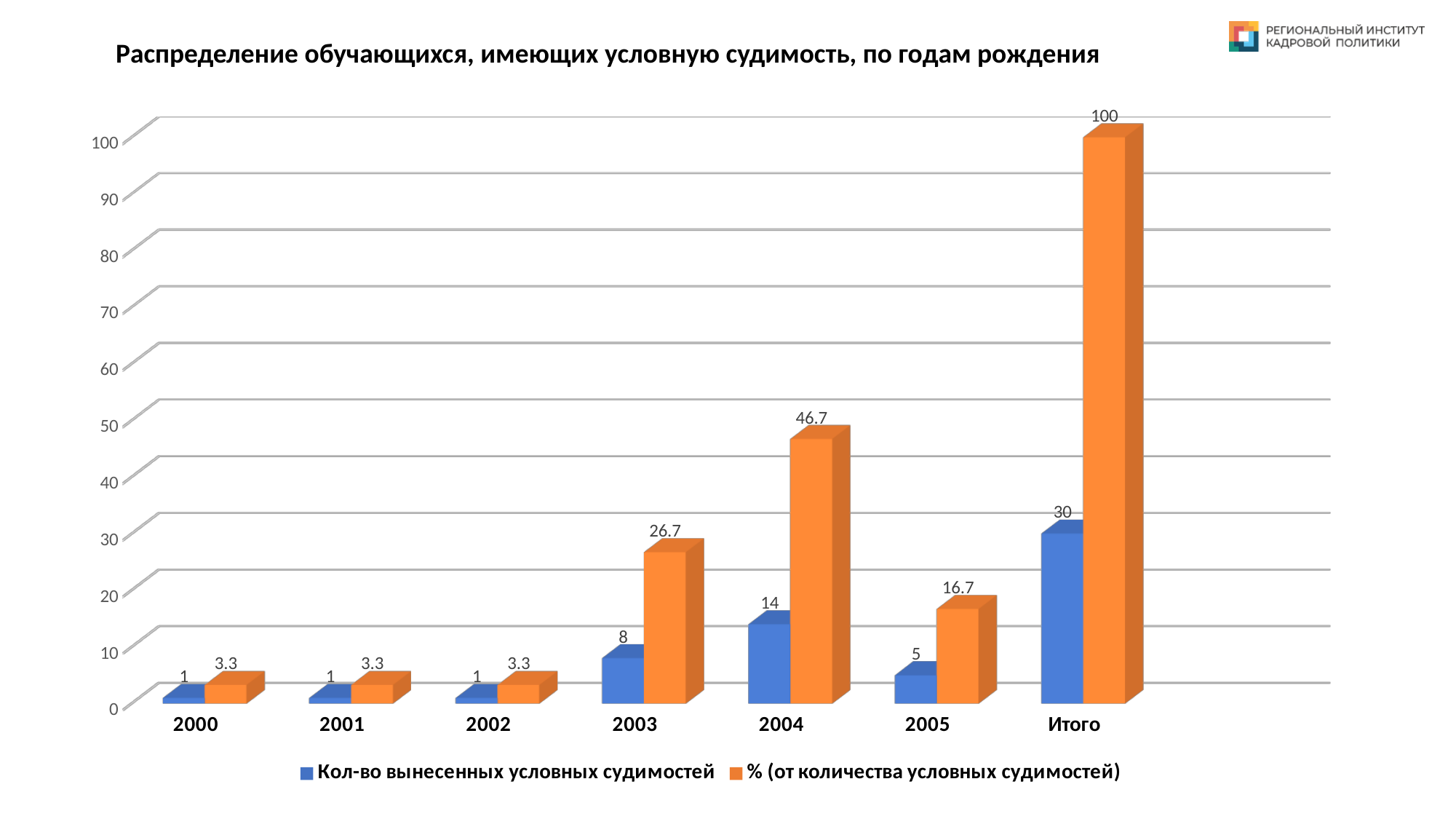
Among the years 2000 to 2005, which year has the highest value of 'Кол-во вынесенных условных судимостей'? 2004 Which is larger: the '% (от количества условных судимостей)' value for 2004 or for 2005? 2004 What is the value of '% (от количества условных судимостей)' for 2003? 26.7 What is the value of 'Кол-во вынесенных условных судимостей' for 2004? 14 What is the difference between the 'Кол-во вынесенных условных судимостей' values for 2004 and 2003? 6 Is the '% (от количества условных судимостей)' value for 2004 greater or less than 40? greater How many categories are shown on the x axis? 7 What is the value of 'Кол-во вынесенных условных судимостей' for Итого? 30 What colour are the bars for the series '% (от количества условных судимостей)'? Orange How many series does the legend list? 2 Which category has the lowest value of '% (от количества условных судимостей)' other than the ties at 3.3 — i.e., what is the lowest percentage value shown? 3.3 What kind of chart is shown on the slide? Bar chart